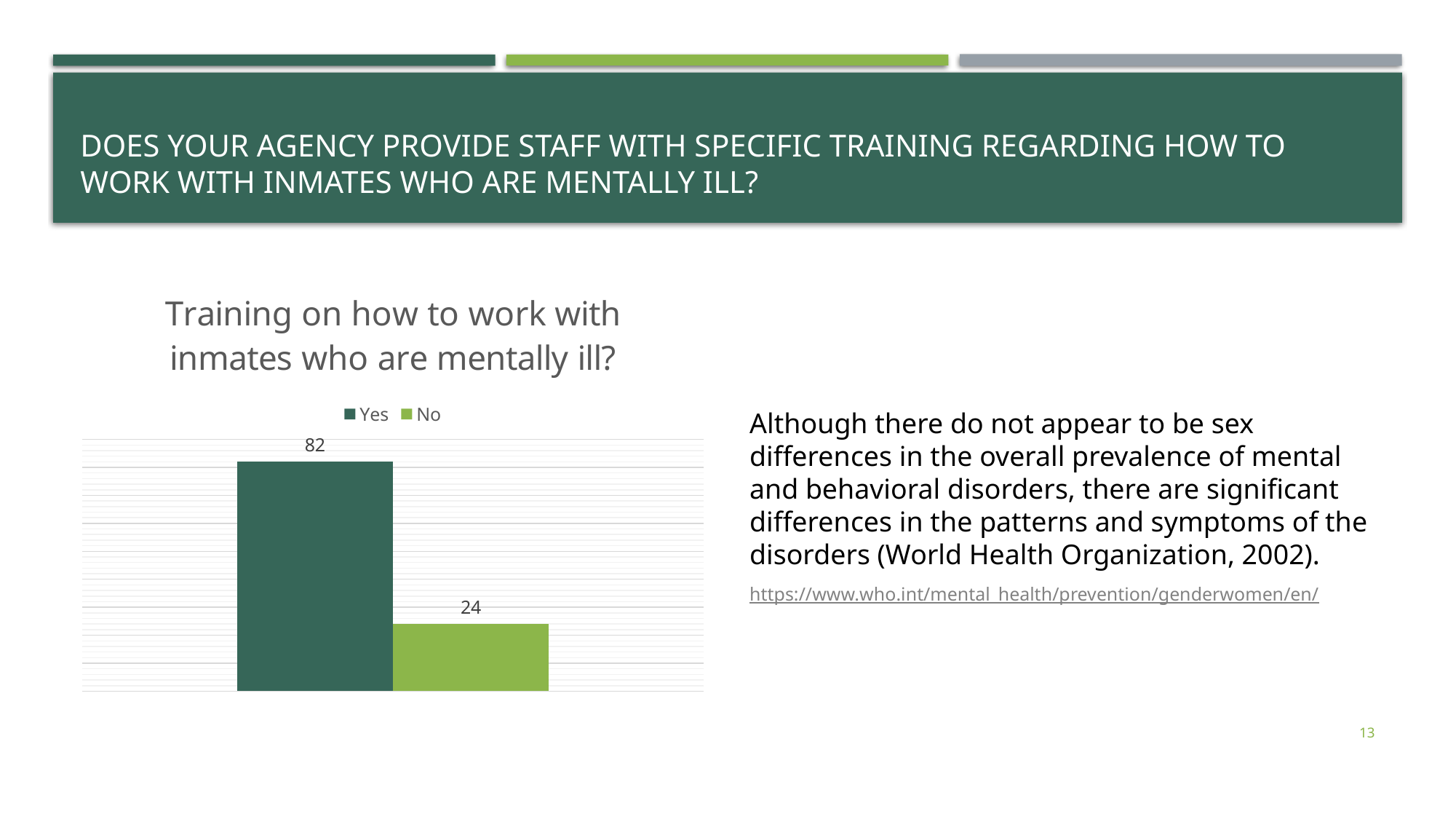
What is the value for Yes? 82 What kind of chart is shown on the slide? Bar chart What is the difference between the Yes and No values? 58 What is the total of the Yes and No values? 106 What colour is the bar for No? Light green What is the value for No? 24 Which series has the highest value? Yes What is the title of the chart? Training on how to work with inmates who are mentally ill? How many series does the legend list? 2 Which is larger, the value for Yes or the value for No? Yes Which series has the lowest value? No